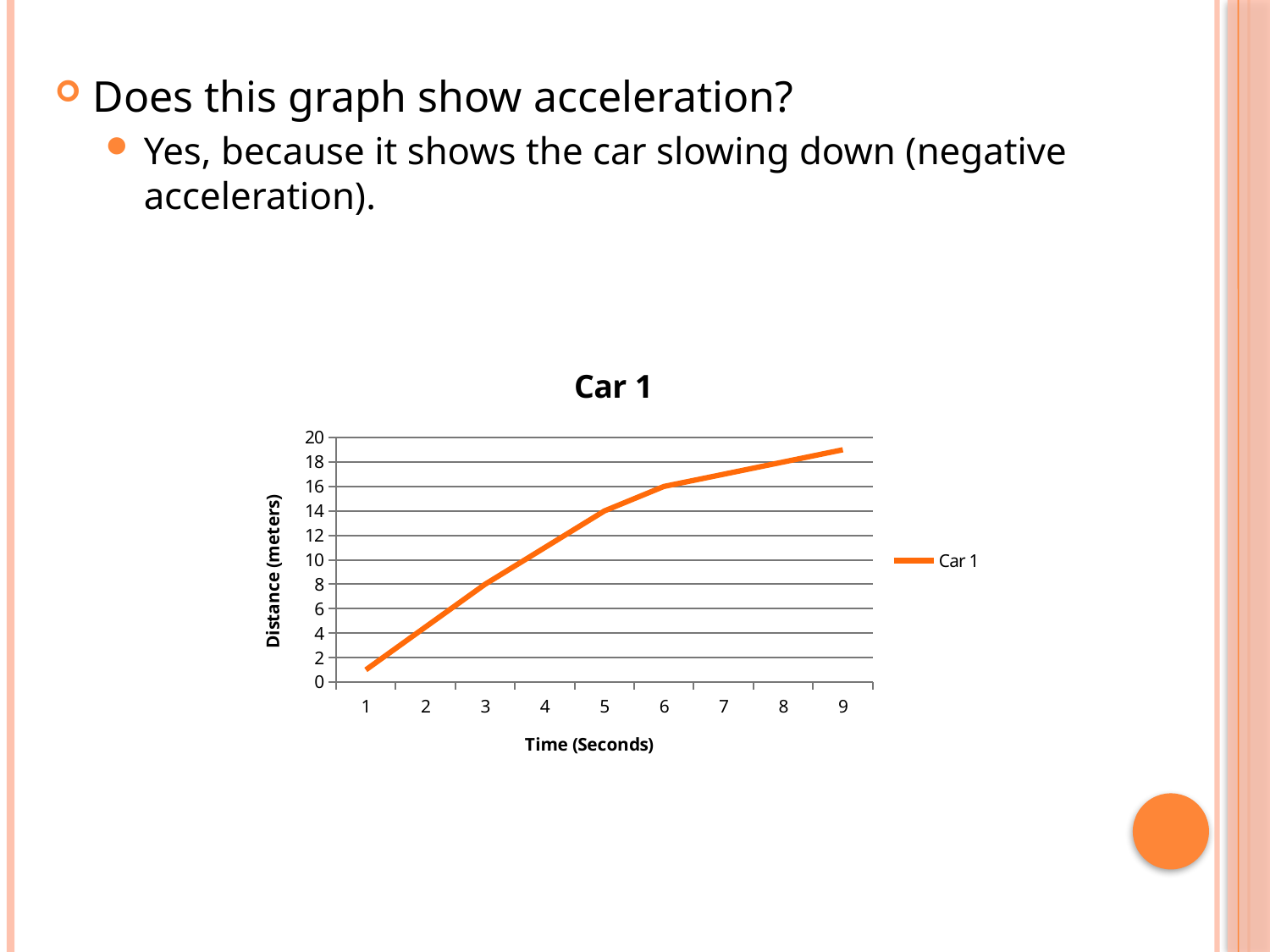
Is the distance at 3 seconds greater or less than 10 meters? less At which time (seconds) is the distance highest? 9 At which time (seconds) is the distance lowest? 1 Is the distance at 2 seconds greater or less than 6 meters? less What kind of chart is shown on the slide? line chart What is the label on the vertical axis? Distance (meters) Does the distance rise or fall as time increases along the x axis? rise What is the title of the chart? Car 1 How many series does the legend list? 1 How many time points are plotted along the x axis? 9 Which is larger, the distance at 4 seconds or the distance at 8 seconds? 8 seconds Is the distance at 7 seconds greater or less than 16 meters? greater